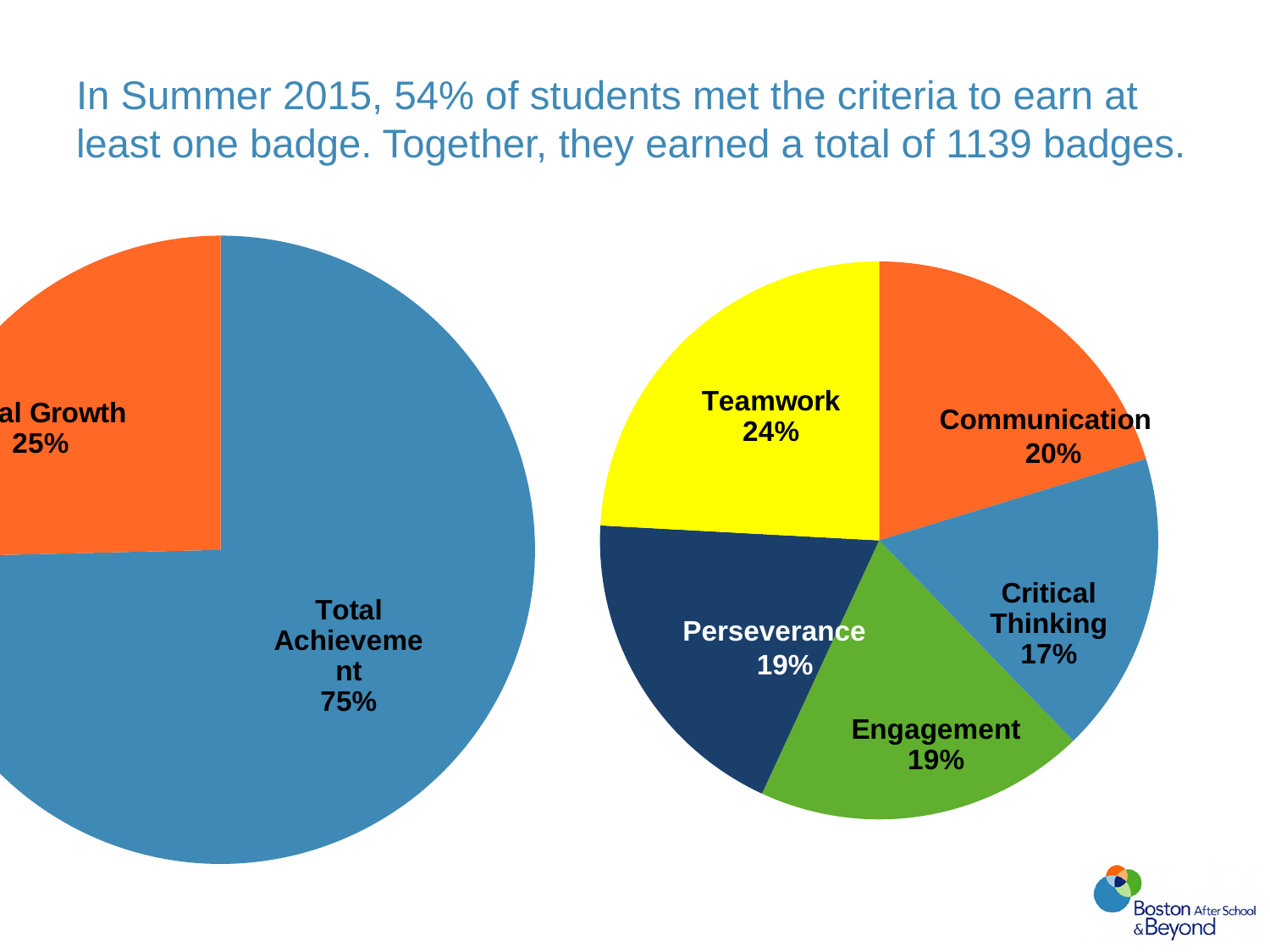
In the right pie chart, what share does Engagement have? 19% In the right pie chart, what share does Communication have? 20% In the right pie chart, what share does Teamwork have? 24% In the right pie chart, which category has the largest share? Teamwork In the right pie chart, which is larger, the share for Communication or the share for Critical Thinking? Communication How many slices does the right pie chart have? 5 In the left pie chart, what percentage is shown on the orange slice? 25% In the right pie chart, what is the difference between the shares of Teamwork and Communication? 4% What kind of chart is the chart on the right of the slide? pie chart In the right pie chart, which category has the smallest share? Critical Thinking